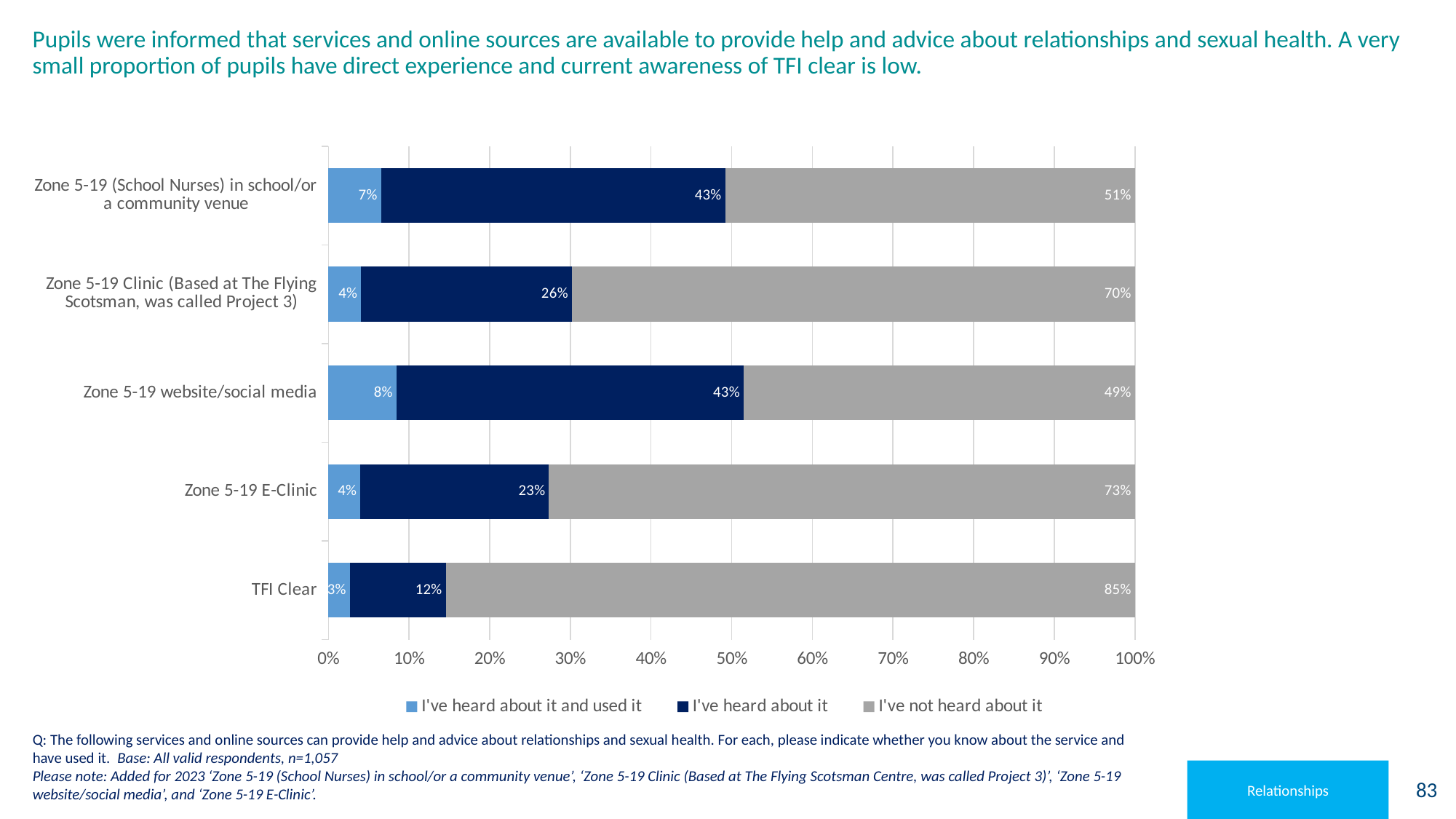
Which colour represents 'I've not heard about it' in the chart? Grey What percentage of pupils have heard about Zone 5-19 Clinic (Based at The Flying Scotsman, was called Project 3)? 26% What is the difference between the 'I've not heard about it' percentages for Zone 5-19 E-Clinic and Zone 5-19 website/social media? 24% What kind of chart is shown on the slide? Stacked bar chart What percentage of pupils have not heard about TFI Clear? 85% How many series does the legend list? 3 Which is larger: the 'I've heard about it' percentage for Zone 5-19 E-Clinic or for Zone 5-19 Clinic (Based at The Flying Scotsman, was called Project 3)? Zone 5-19 Clinic (Based at The Flying Scotsman, was called Project 3) Which service has the lowest percentage of pupils who have heard about it? TFI Clear What is the combined percentage of pupils who have heard about Zone 5-19 (School Nurses) in school/or a community venue, including those who have used it? 50% Which service has the highest percentage of pupils who have not heard about it? TFI Clear How many services are shown in the chart? 5 What percentage of pupils have heard about and used Zone 5-19 website/social media? 8%